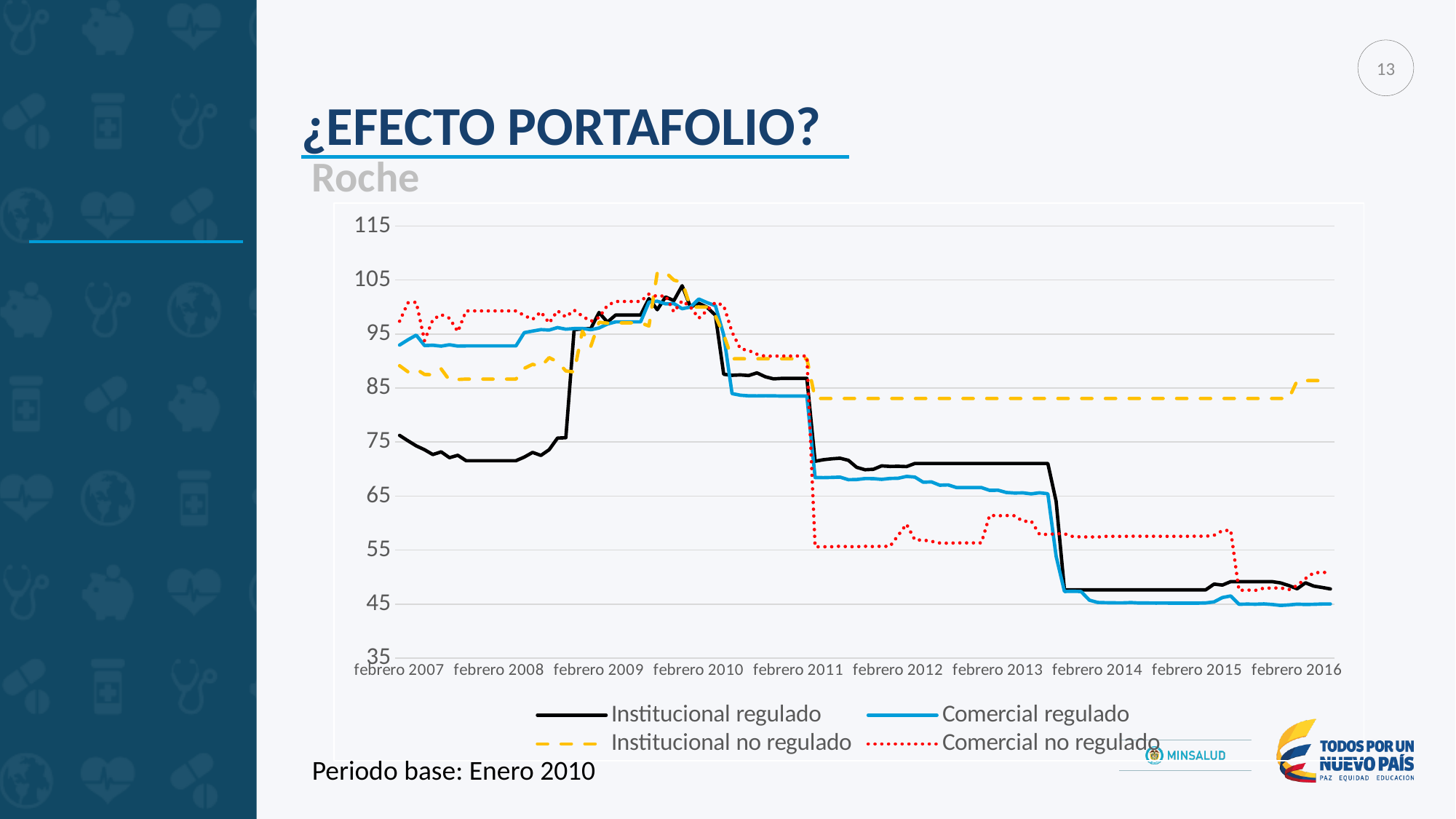
Which series has the highest value at febrero 2016? Institucional no regulado How many series does the legend list? 4 Is the value for Comercial regulado at febrero 2016 greater or less than 55? less At febrero 2012, which is larger: Institucional regulado or Comercial no regulado? Institucional regulado Is the value for Institucional no regulado at febrero 2014 greater or less than 75? greater What base period is stated below the chart? Enero 2010 What kind of chart is shown on the slide? line chart Is the value for Comercial no regulado at febrero 2008 greater or less than 95? greater How many year labels are shown on the x axis? 10 Does the Institucional regulado series rise or fall from febrero 2010 to febrero 2016? fall Which series are listed in the legend? Institucional regulado, Comercial regulado, Institucional no regulado, Comercial no regulado